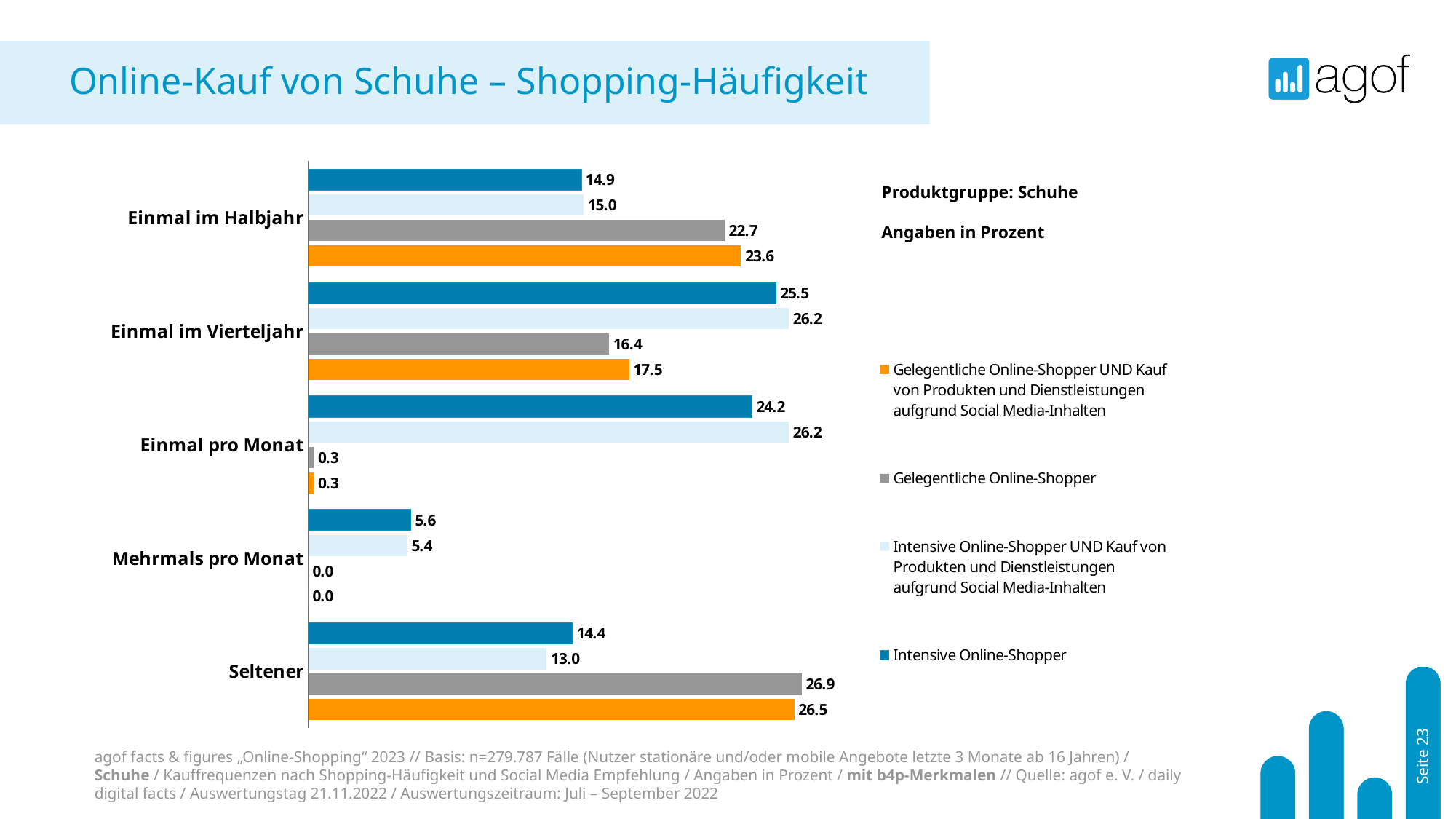
How many categories (shopping frequencies) are shown on the chart? 5 According to the text on the slide, in what unit are the values given? Prozent In the category Einmal pro Monat, which is larger: the value for Intensive Online-Shopper or the value for Gelegentliche Online-Shopper? Intensive Online-Shopper What is the value for Gelegentliche Online-Shopper in the category Seltener? 26.9 What is the difference between the Gelegentliche Online-Shopper value and the Intensive Online-Shopper value in the category Einmal im Halbjahr? 7.8 How many series does the legend list? 4 What is the value for Intensive Online-Shopper in the category Einmal im Vierteljahr? 25.5 What kind of chart is shown on the slide? bar chart What is the value for Gelegentliche Online-Shopper UND Kauf von Produkten und Dienstleistungen aufgrund Social Media-Inhalten in the category Einmal im Halbjahr? 23.6 In which category does the Intensive Online-Shopper series have its lowest value? Mehrmals pro Monat What is the value for Intensive Online-Shopper UND Kauf von Produkten und Dienstleistungen aufgrund Social Media-Inhalten in the category Mehrmals pro Monat? 5.4 In which category does the Gelegentliche Online-Shopper series have its highest value? Seltener